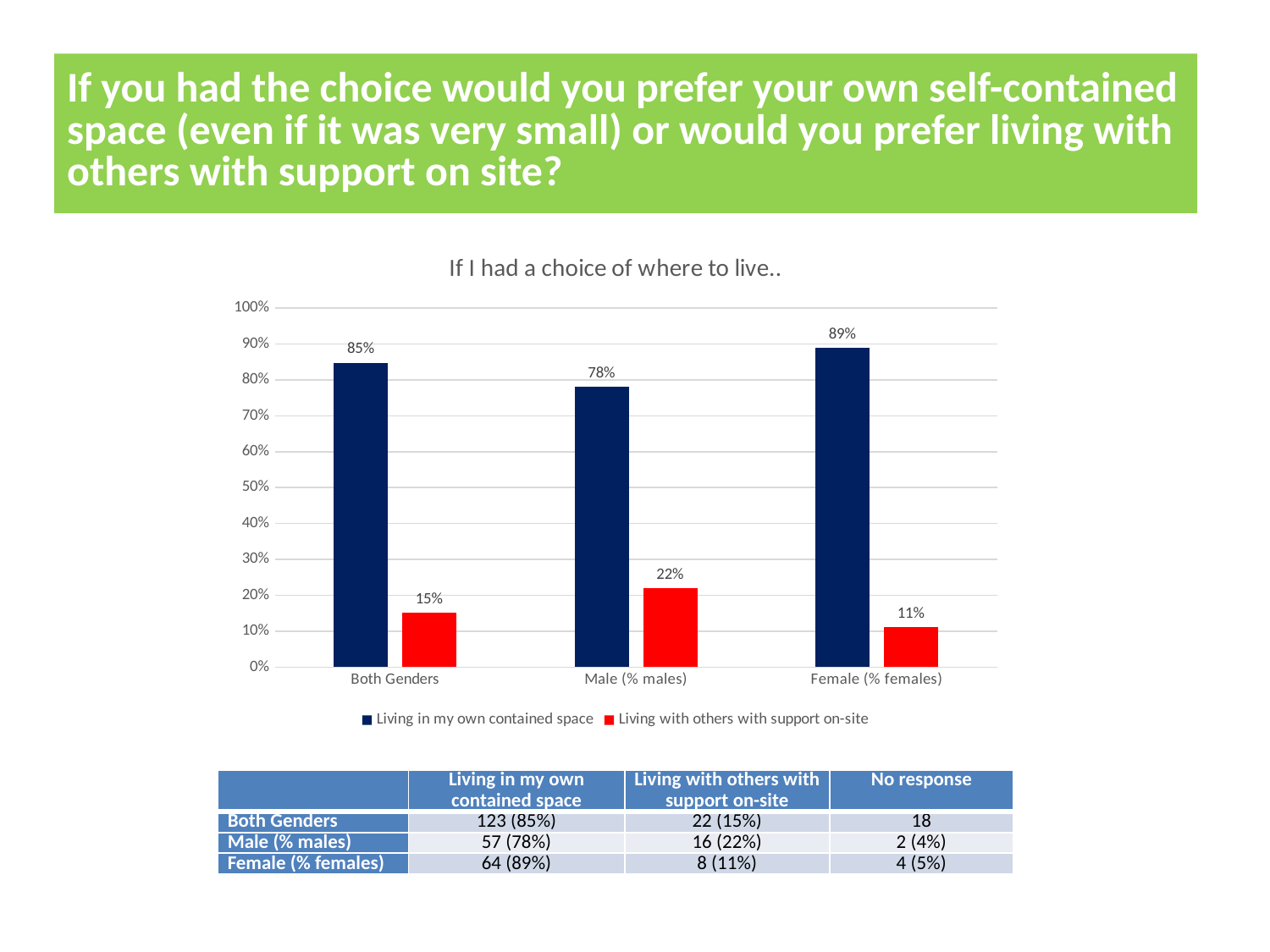
Which category has the highest value for 'Living in my own contained space'? Female (% females) What is the value for 'Living in my own contained space' for Female (% females)? 89% Which category has the lowest value for 'Living with others with support on-site'? Female (% females) Is the value for 'Living in my own contained space' for Male (% males) greater or less than 70%? greater What kind of chart is shown? bar chart What is the value for 'Living in my own contained space' for Both Genders? 85% What is the value for 'Living with others with support on-site' for Male (% males)? 22% How many categories are shown on the x axis? 3 What is the difference between the 'Living in my own contained space' values for Female (% females) and Male (% males)? 11% Which is larger: the 'Living with others with support on-site' value for Both Genders or for Male (% males)? Male (% males) What is the title of the chart? If I had a choice of where to live.. How many series does the legend list? 2